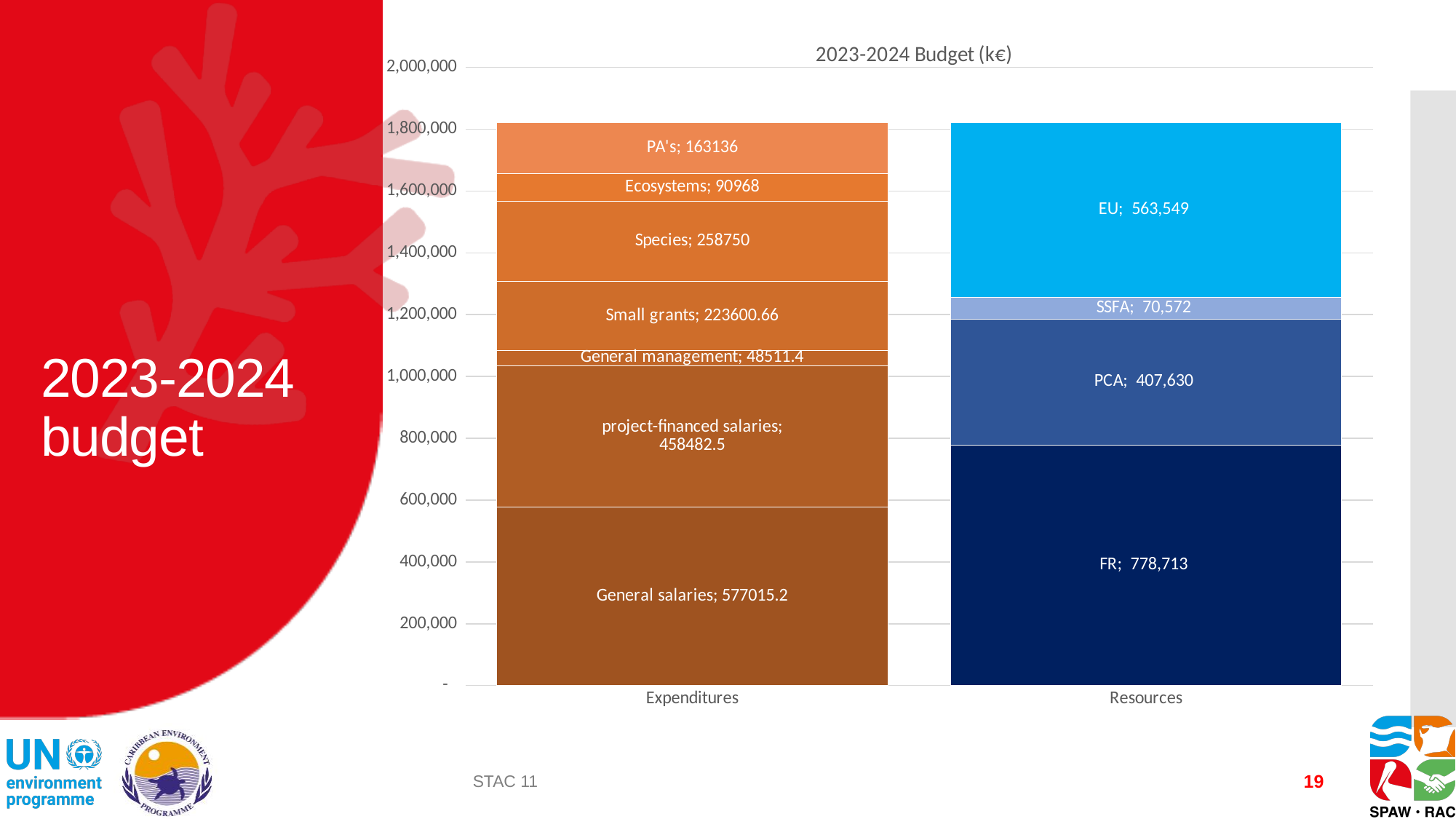
What is the value of the Small grants segment in the Expenditures bar? 223600.66 What kind of chart is shown on the slide? Stacked bar chart What is the title of the chart? 2023-2024 Budget (k€) What is the value of the Species segment in the Expenditures bar? 258750 What is the difference between the EU and PCA values in the Resources bar? 155,919 How many categories are shown on the x axis? 2 What is the total of the Resources bar? 1,820,464 What is the value of the FR segment in the Resources bar? 778,713 Which segment of the Resources bar is the largest? FR What is the value of the SSFA segment in the Resources bar? 70,572 Which is larger, the Species segment or the PA's segment in the Expenditures bar? Species Which segment of the Expenditures bar is the smallest? General management